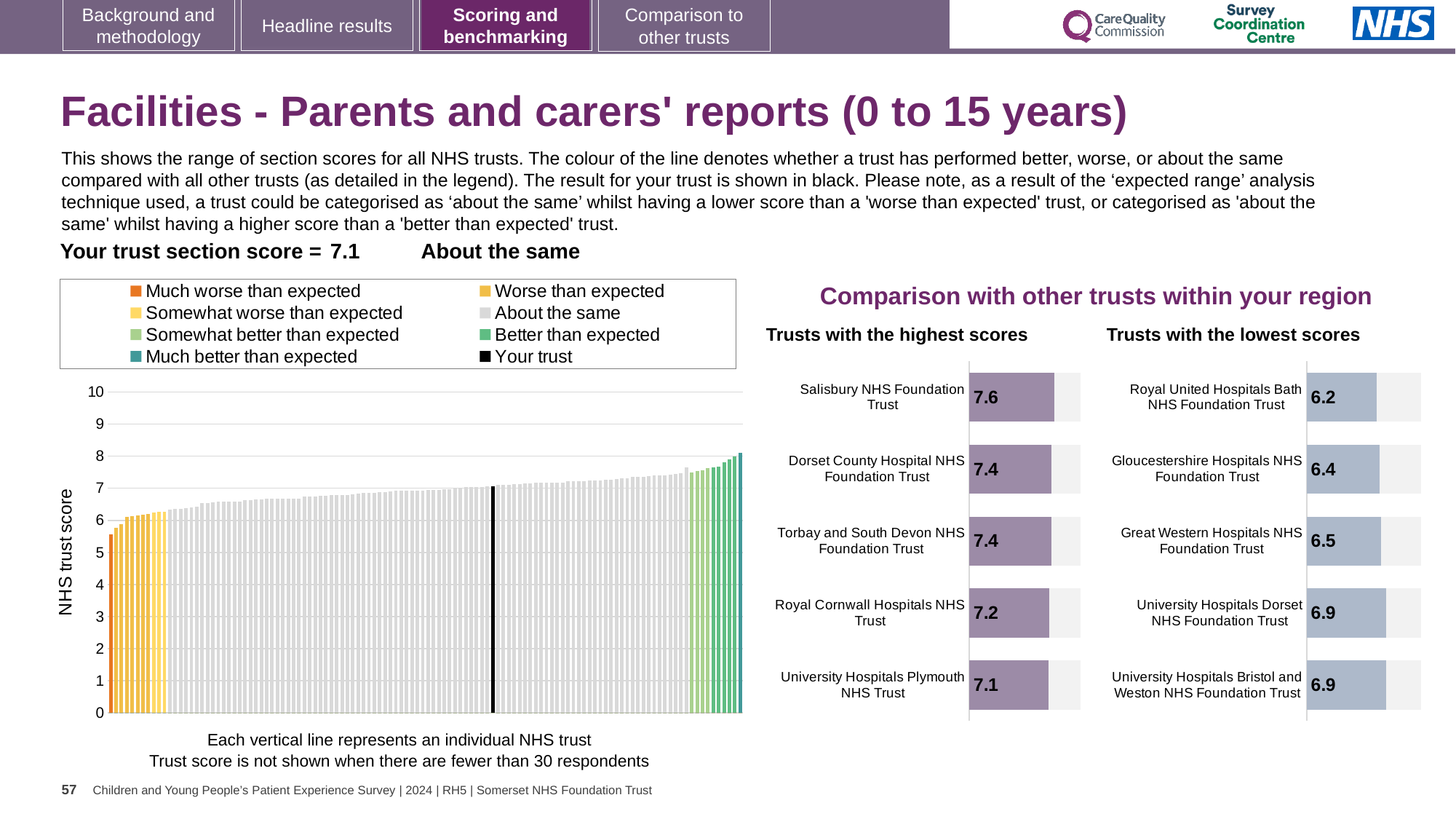
In the 'Trusts with the lowest scores' chart, which has the larger score: Gloucestershire Hospitals NHS Foundation Trust or Great Western Hospitals NHS Foundation Trust? Great Western Hospitals NHS Foundation Trust In the 'Trusts with the highest scores' chart, which trust has the highest score? Salisbury NHS Foundation Trust In the 'Trusts with the highest scores' chart, what is the score for Salisbury NHS Foundation Trust? 7.6 In the large chart on the left, what is the section score for your trust (the black bar)? 7.1 In the 'Trusts with the lowest scores' chart, what is the score for Royal United Hospitals Bath NHS Foundation Trust? 6.2 How many trusts are listed in the 'Trusts with the highest scores' chart? 5 In the 'Trusts with the highest scores' chart, what is the difference between the scores of Salisbury NHS Foundation Trust and University Hospitals Plymouth NHS Trust? 0.5 What kind of chart is the large chart on the left showing NHS trust scores? Bar chart In the 'Trusts with the lowest scores' chart, which trust has the lowest score? Royal United Hospitals Bath NHS Foundation Trust In the 'Trusts with the highest scores' chart, what is the score for Royal Cornwall Hospitals NHS Trust? 7.2 How many entries does the legend above the large chart on the left list? 8 In the 'Trusts with the lowest scores' chart, what is the score for University Hospitals Dorset NHS Foundation Trust? 6.9